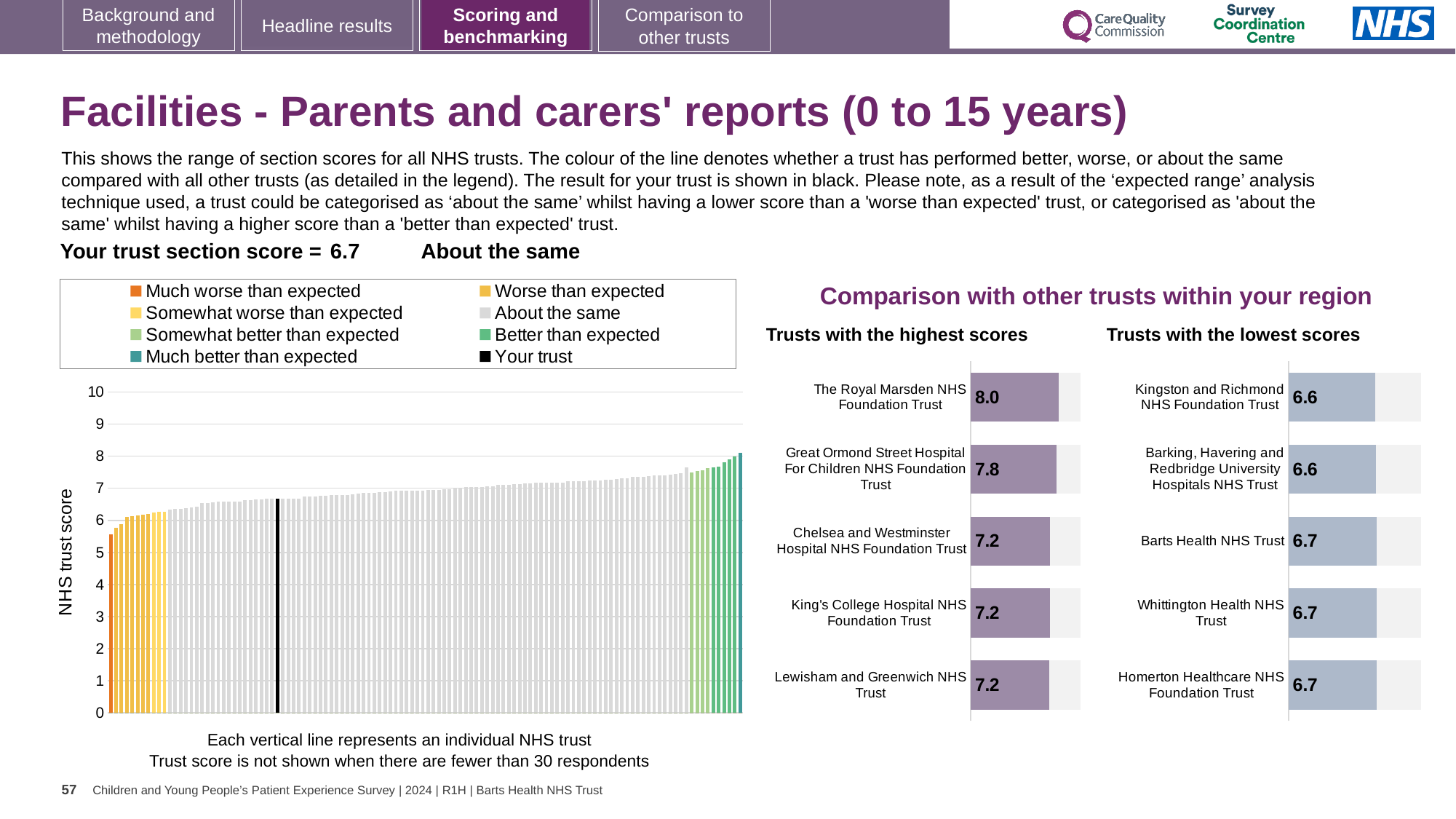
In the 'Trusts with the highest scores' chart, what is the score for Great Ormond Street Hospital For Children NHS Foundation Trust? 7.8 In the 'Trusts with the lowest scores' chart, what is the score for Whittington Health NHS Trust? 6.7 What type of chart is the 'Trusts with the highest scores' chart? bar chart How many trusts are shown in the 'Trusts with the lowest scores' chart? 5 In the 'Trusts with the lowest scores' chart, what is the score for Kingston and Richmond NHS Foundation Trust? 6.6 Which is larger: the score for The Royal Marsden NHS Foundation Trust in the highest scores chart or the score for Barts Health NHS Trust in the lowest scores chart? The Royal Marsden NHS Foundation Trust In the large chart on the left showing all NHS trusts, is the value for the lowest (leftmost) trust greater or less than 6? less In the 'Trusts with the highest scores' chart, which trust has the highest score? The Royal Marsden NHS Foundation Trust In the 'Trusts with the highest scores' chart, what is the difference between the scores of The Royal Marsden NHS Foundation Trust and Great Ormond Street Hospital For Children NHS Foundation Trust? 0.2 In the large chart on the left showing all NHS trusts, do the trust scores rise or fall from left to right? rise How many entries does the legend of the large chart on the left list? 8 In the 'Trusts with the highest scores' chart, what is the score for The Royal Marsden NHS Foundation Trust? 8.0